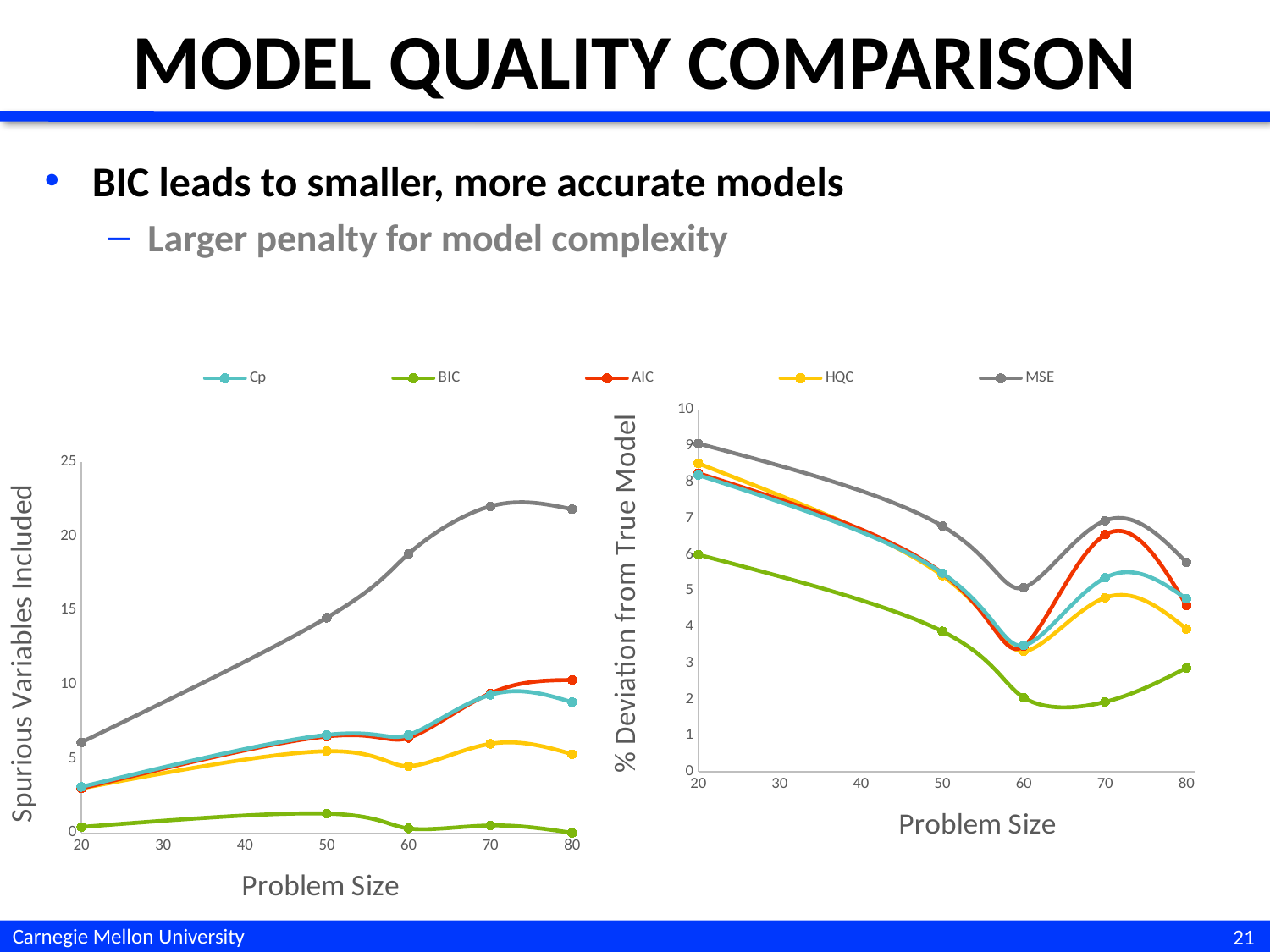
In the right chart (% Deviation from True Model), does the MSE series rise or fall from problem size 20 to 60? fall In the left chart (Spurious Variables Included), is the MSE value at problem size 80 greater or less than 20? greater In the right chart (% Deviation from True Model), which is larger at problem size 70, AIC or HQC? AIC In the right chart (% Deviation from True Model), is the BIC value at problem size 70 greater or less than 3? less What kind of chart is the left chart titled with the y-axis 'Spurious Variables Included'? line chart In the left chart (Spurious Variables Included), is the MSE value at problem size 60 greater or less than 15? greater How many series does the legend list? 5 In the left chart (Spurious Variables Included), which series has the lowest values across all problem sizes? BIC In the right chart (% Deviation from True Model), which series has the lowest value at problem size 80? BIC In the left chart (Spurious Variables Included), which series has the highest values across all problem sizes? MSE